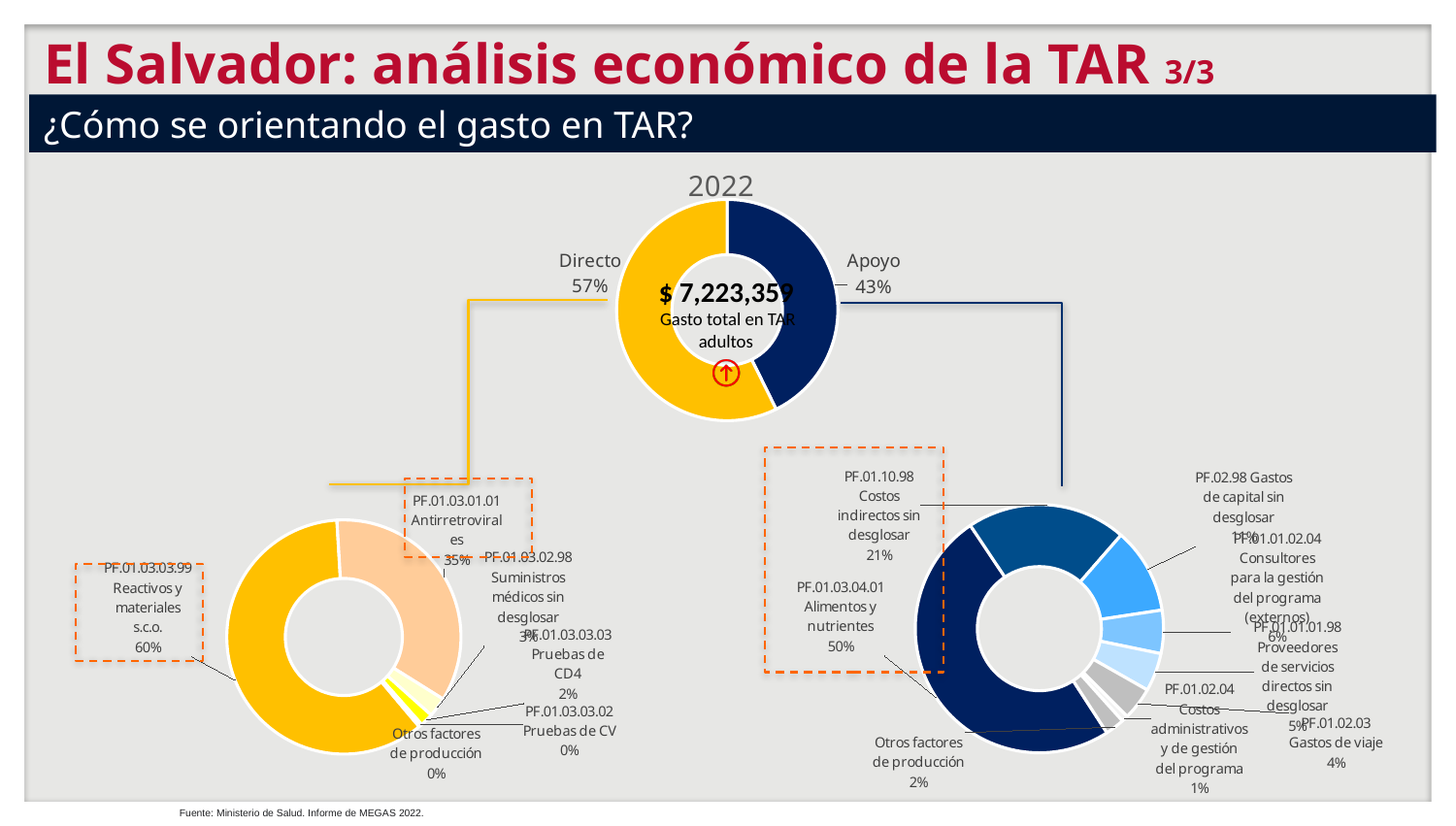
In the bottom-left donut chart, what share is PF.01.03.01.01 Antirretrovirales? 35% In the top donut chart labelled 2022, what is the difference in percentage points between Directo and Apoyo? 14 percentage points In the top donut chart labelled 2022, which is larger, Directo or Apoyo? Directo What kind of chart is the top chart labelled 2022? Donut (pie) chart In the bottom-left donut chart, what share is PF.01.03.03.99 Reactivos y materiales s.c.o.? 60% In the bottom-left donut chart, which category has the largest share? PF.01.03.03.99 Reactivos y materiales s.c.o. In the top donut chart labelled 2022, what share of spending is Apoyo? 43% In the top donut chart labelled 2022, what share of spending is Directo? 57% In the top donut chart labelled 2022, what is the total amount shown in the centre (Gasto total en TAR adultos)? $ 7,223,359 In the bottom-right donut chart, what share is PF.01.03.04.01 Alimentos y nutrientes? 50% In the bottom-right donut chart, what share is PF.01.02.03 Gastos de viaje? 4% In the bottom-right donut chart, what share is PF.01.10.98 Costos indirectos sin desglosar? 21%